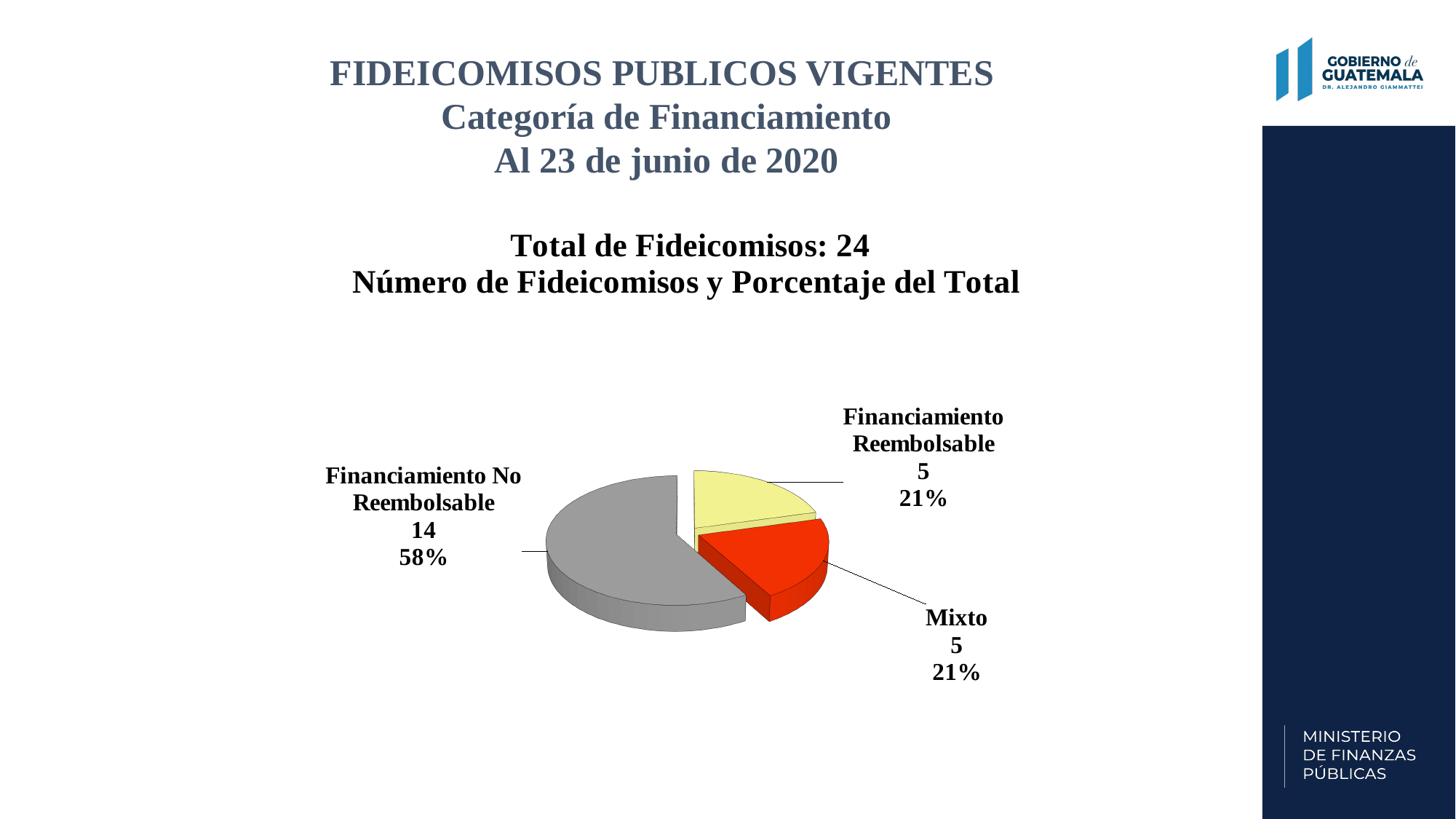
How many slices does the pie chart have? 3 How many fideicomisos are in the Financiamiento No Reembolsable category? 14 As of what date is the data on the slide reported? 23 de junio de 2020 What is the total number of fideicomisos shown on the slide? 24 What is the difference in number of fideicomisos between Financiamiento No Reembolsable and Mixto? 9 Which category has the largest slice of the pie? Financiamiento No Reembolsable What colour is the Mixto slice of the pie chart? Red What percentage of the total does Financiamiento Reembolsable represent? 21% How many fideicomisos are in the Mixto category? 5 Which is larger, the number of fideicomisos for Financiamiento No Reembolsable or for Financiamiento Reembolsable? Financiamiento No Reembolsable What share of the pie does Financiamiento No Reembolsable represent? 58% What kind of chart is shown on the slide? Pie chart